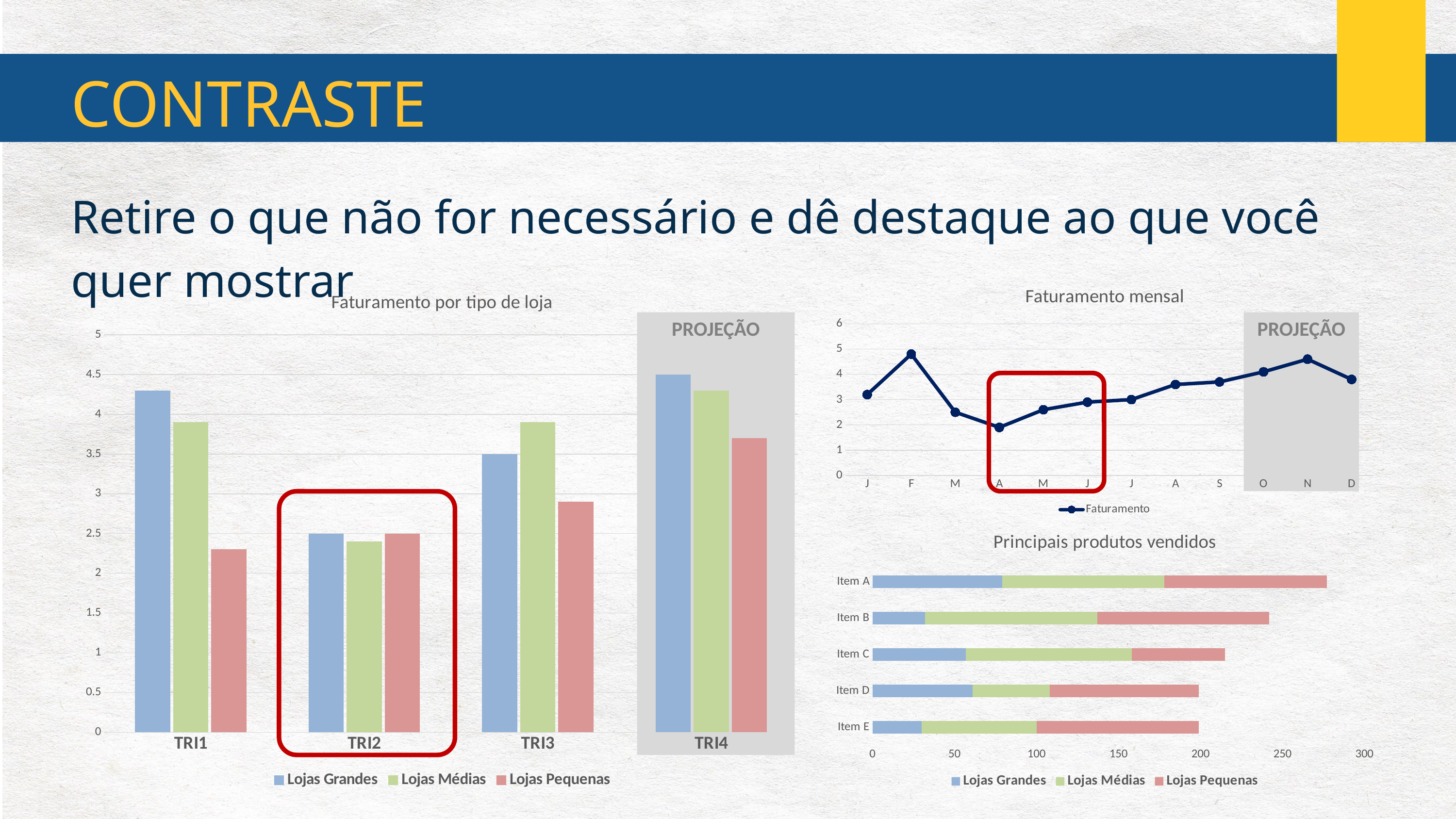
In 'Faturamento por tipo de loja', is the value for Lojas Pequenas in TRI2 greater or less than 3? less In 'Faturamento por tipo de loja', which is larger in TRI1: Lojas Grandes or Lojas Pequenas? Lojas Grandes In 'Principais produtos vendidos', which item has the longest total bar? Item A What kind of chart is 'Faturamento mensal'? line chart In 'Faturamento por tipo de loja', how many series does the legend list? 3 In 'Faturamento mensal', how many data points are plotted? 12 In 'Faturamento mensal', which month has the lowest value? A In 'Faturamento por tipo de loja', how many quarters are shown on the x axis? 4 In 'Faturamento mensal', which month has the highest value? F In 'Faturamento por tipo de loja', which quarter is marked as PROJEÇÃO? TRI4 In 'Faturamento por tipo de loja', is the value for Lojas Grandes in TRI1 greater or less than 4? greater What kind of chart is 'Faturamento por tipo de loja'? bar chart